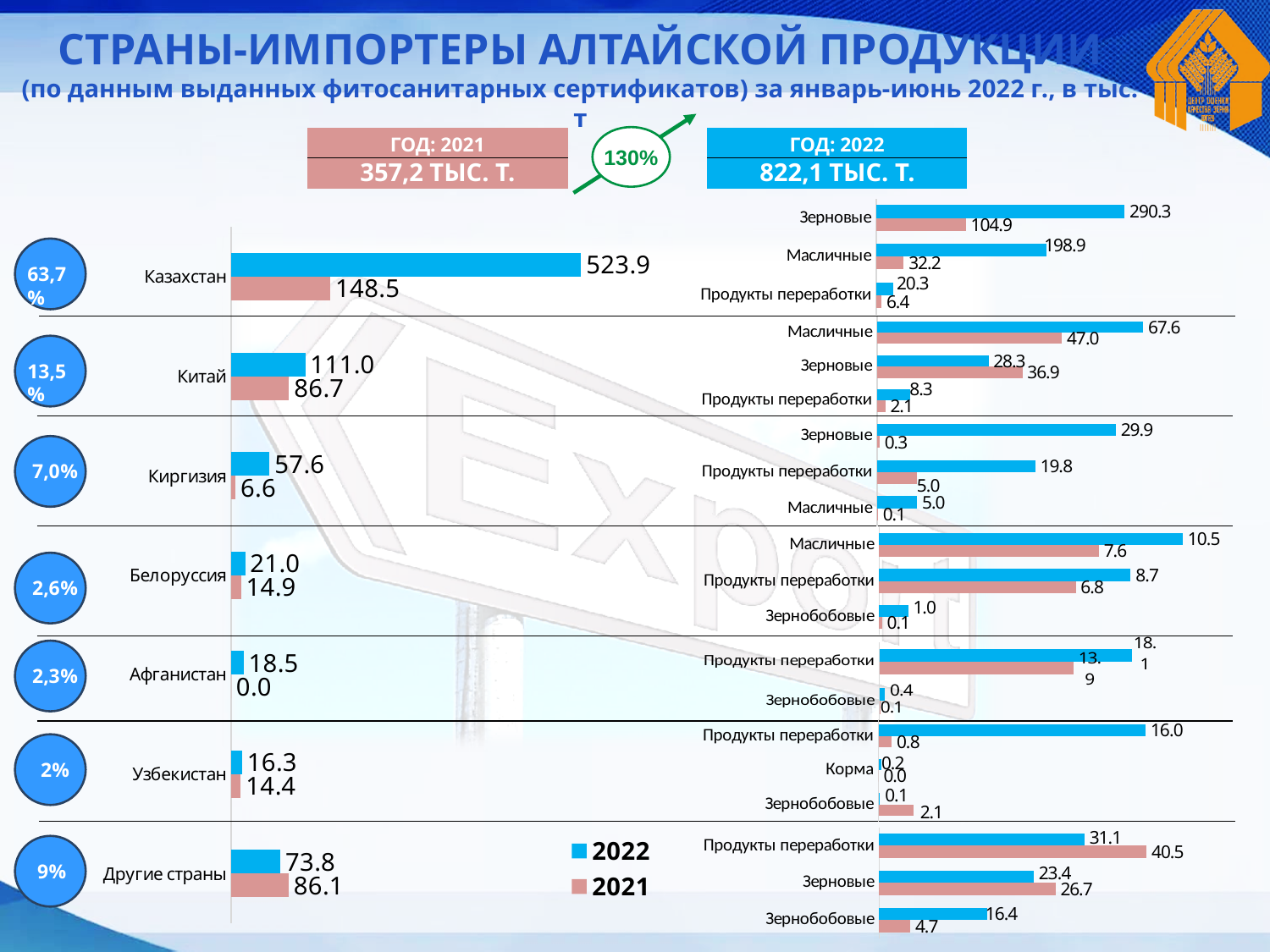
In the left chart of countries, what is the difference between the 2022 and 2021 values for Киргизия? 51.0 In the right-hand chart for Другие страны, what is the 2021 value for Продукты переработки? 40.5 In the right-hand chart for Казахстан, what is the 2022 value for Зерновые? 290.3 In the right-hand chart for Китай, which is larger for Зерновые: the 2022 value or the 2021 value? 2021 In the left chart of countries, which country has the highest 2022 value? Казахстан What kind of chart is used on the slide? bar chart In the left chart of countries, which is larger for Другие страны: the 2022 value or the 2021 value? 2021 In the left chart of countries, which country has the lowest 2021 value? Афганистан In the left chart of countries, what is the 2022 value for Казахстан? 523.9 How many series does the legend list? 2 How many countries (categories) are shown in the left chart? 7 In the left chart of countries, what is the 2021 value for Китай? 86.7